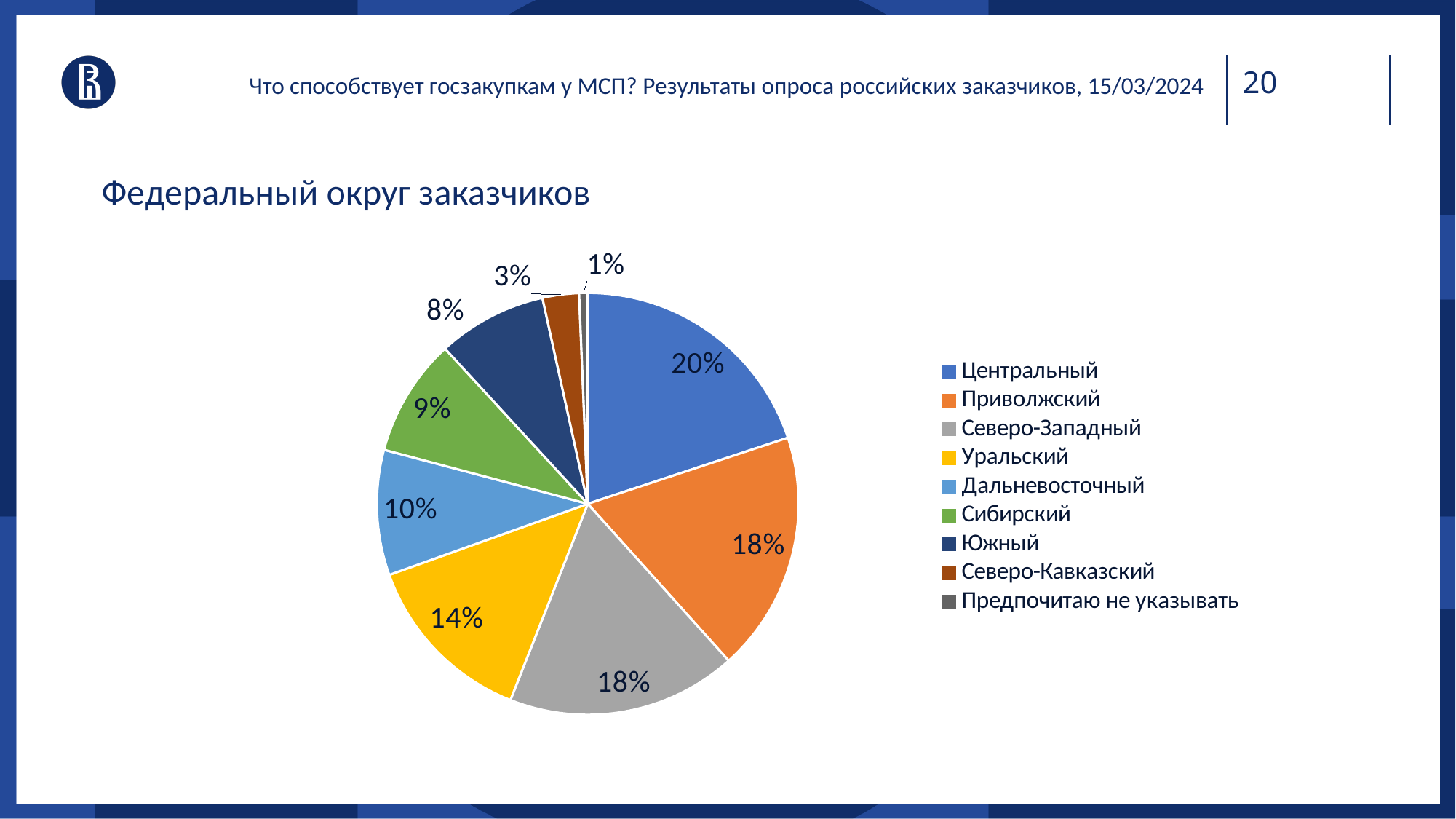
How many categories does the legend list? 9 What is the value for Уральский? 14% Which is larger, the value for Сибирский or the value for Уральский? Уральский What is the value for Дальневосточный? 10% Which category has the largest slice of the pie? Центральный What is the difference between the values for Центральный and Южный? 12% What colour is the slice for Приволжский? orange What type of chart is shown on the slide? pie chart What share of the pie does Центральный have? 20% Which category has the smallest slice of the pie? Предпочитаю не указывать What is the value for Северо-Кавказский? 3% What is the title of the chart? Федеральный округ заказчиков